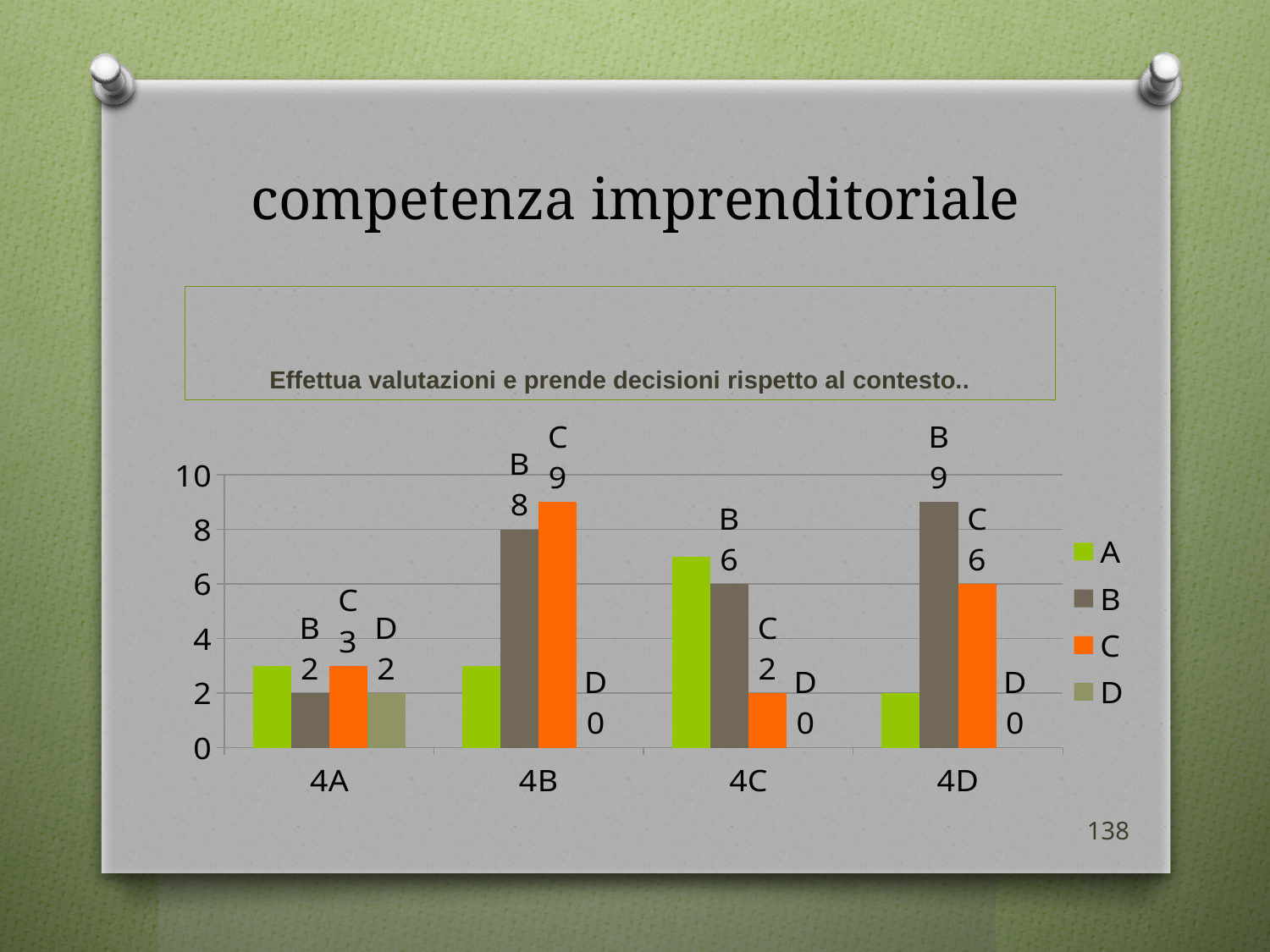
Is the value of series A for category 4C greater or less than 6? greater How many series does the legend list? 4 Which category has the lowest value for series C? 4C What is the value of series C for category 4D? 6 What kind of chart is shown on the slide? bar chart How many categories are shown on the x axis? 4 Which is larger: series B for 4C or series C for 4C? series B for 4C What is the value of series B for category 4B? 8 What is the difference between the series C value for 4B and the series C value for 4A? 6 What is the value of series C for category 4C? 2 Which category has the highest value for series B? 4D What is the value of series D for category 4A? 2